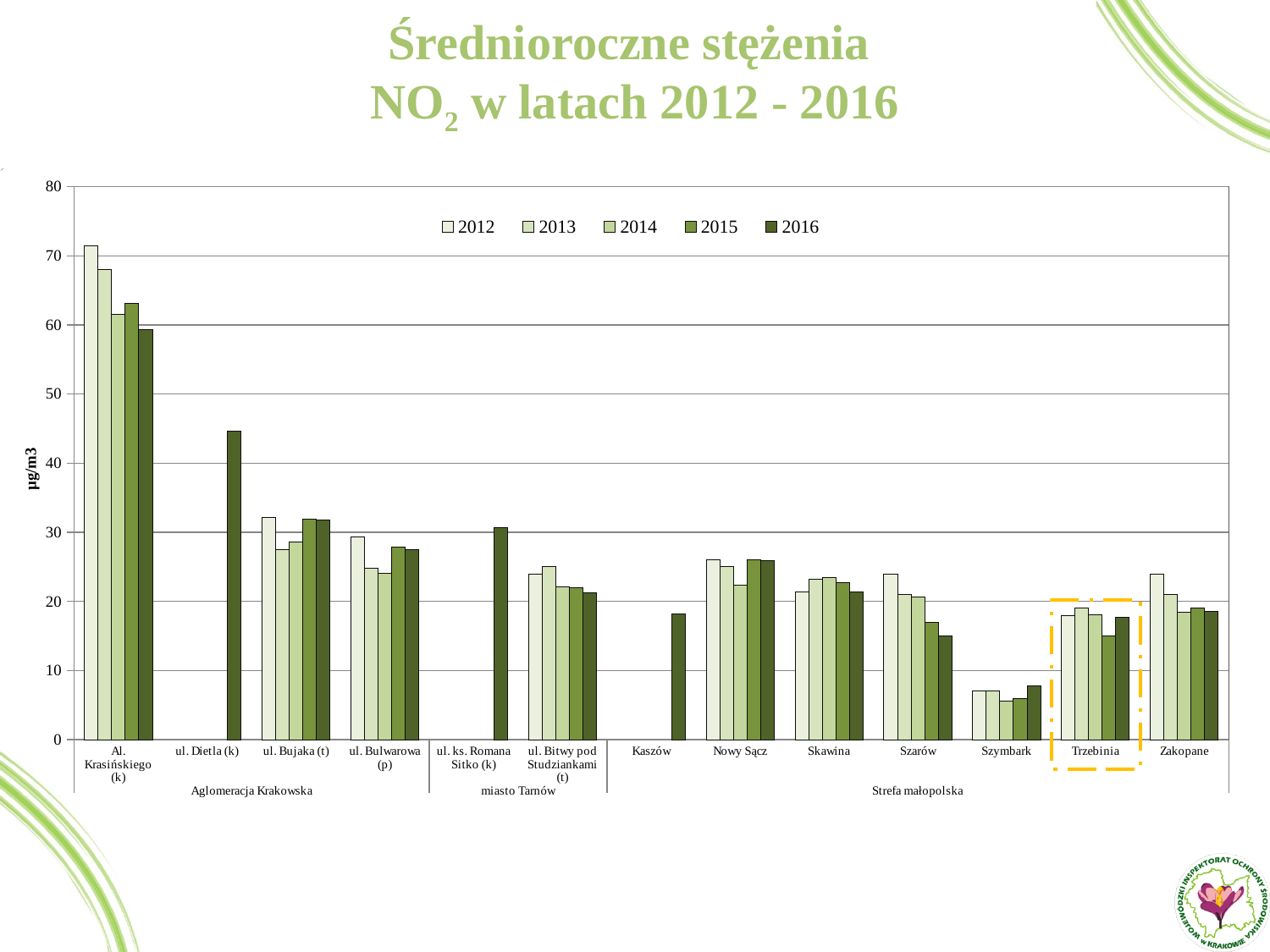
Is the 2012 value for Al. Krasińskiego (k) greater or less than 70? greater Which station is highlighted with a dashed orange box? Trzebinia Is the 2016 value for ul. Dietla (k) greater or less than 40? greater Do the values for Szarów rise or fall from 2012 to 2016? fall Which station has the highest bar in the chart? Al. Krasińskiego (k) What kind of chart is shown on the slide? bar chart Is the 2016 value for Szymbark greater or less than 10? less How many series does the legend list? 5 How many measurement stations (categories) are shown on the x axis? 13 Which is larger, the 2012 value for Nowy Sącz or the 2012 value for Skawina? Nowy Sącz Which station has the lowest bars in the chart? Szymbark